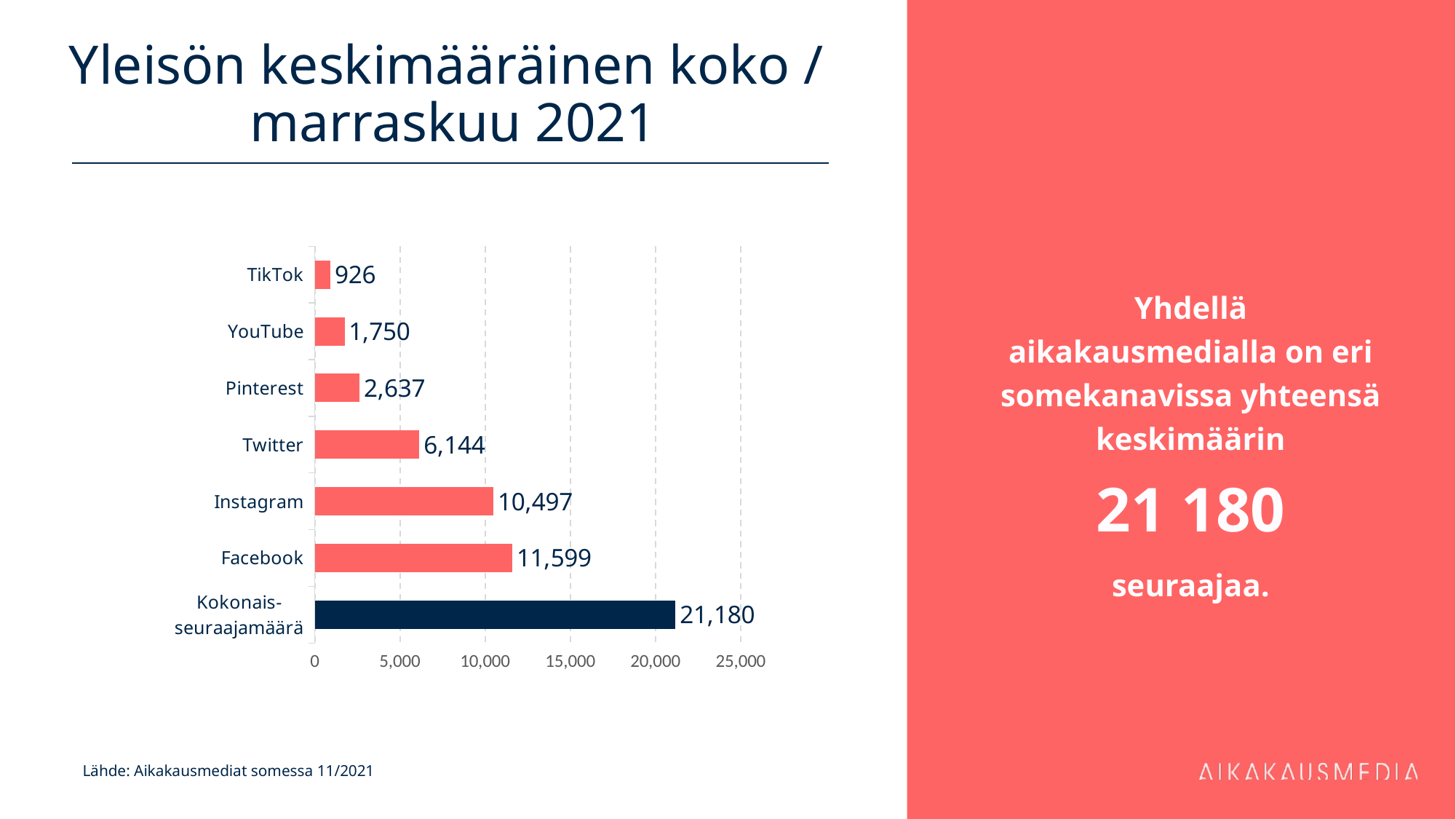
Which is larger, the value for YouTube or the value for Pinterest? Pinterest What is the value for Facebook? 11,599 Which individual social media channel (excluding the total bar) has the highest value? Facebook What is the value for Kokonais-seuraajamäärä? 21,180 Is the value for Twitter greater or less than 5,000? greater What is the difference between the values for Twitter and Pinterest? 3,507 What is the value for Instagram? 10,497 Which category has the lowest value? TikTok What is the value for TikTok? 926 How many categories are shown in the chart? 7 What kind of chart is shown on the slide? Bar chart What is the difference between the values for Facebook and Instagram? 1,102